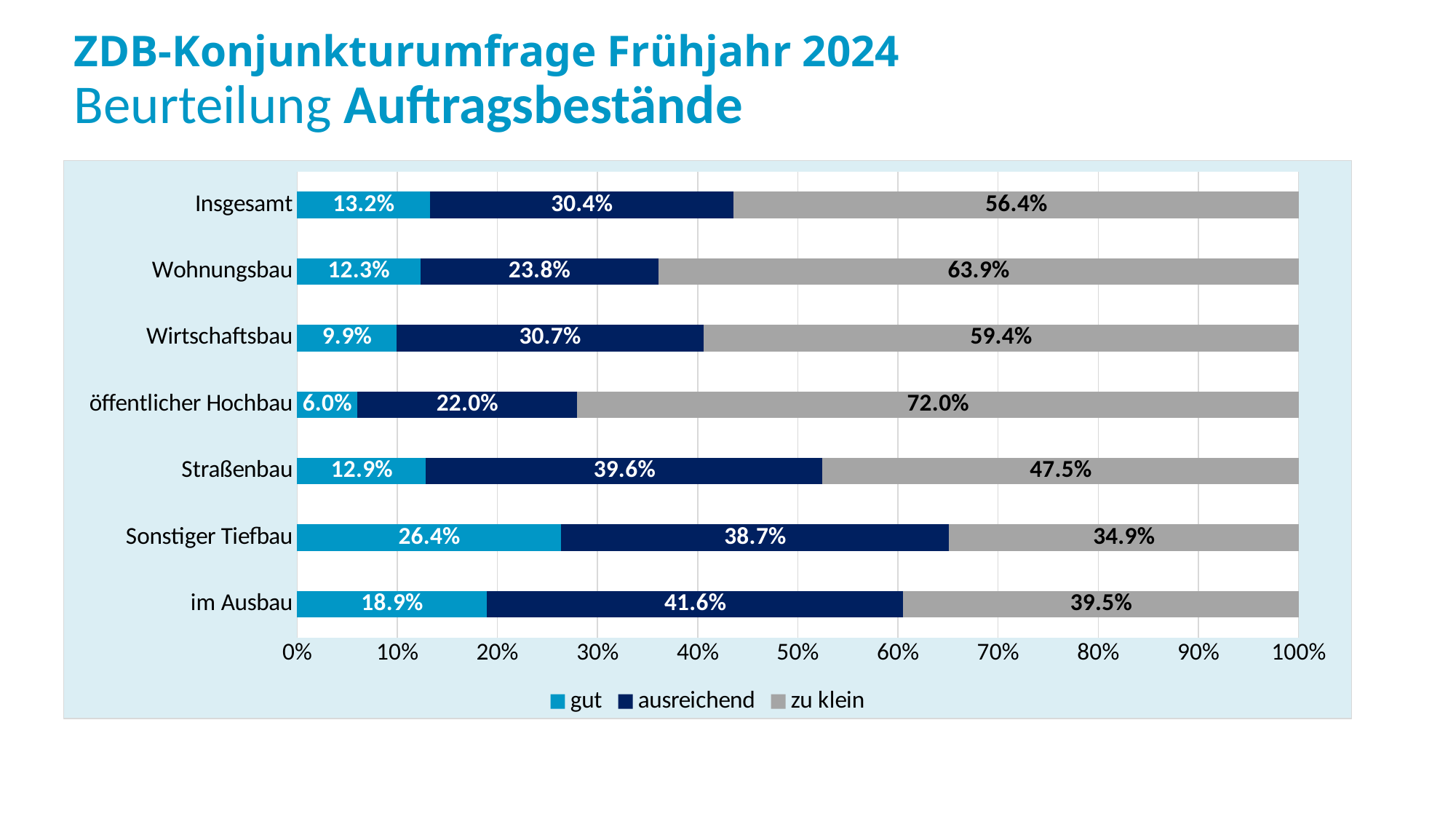
How many categories are shown on the y axis? 7 Which is larger: the 'ausreichend' value for Straßenbau or for Wirtschaftsbau? Straßenbau How many series does the legend list? 3 Is the 'gut' value for Sonstiger Tiefbau greater or less than 20%? greater What is the 'ausreichend' value for im Ausbau? 41.6% Which legend entry is shown in grey? zu klein What is the 'zu klein' value for öffentlicher Hochbau? 72.0% Which category has the lowest 'zu klein' value? Sonstiger Tiefbau What is the difference between the 'zu klein' values for Wohnungsbau and Straßenbau? 16.4% What is the 'gut' value for Insgesamt? 13.2% Which category has the highest 'gut' value? Sonstiger Tiefbau What kind of chart is shown? Stacked bar chart